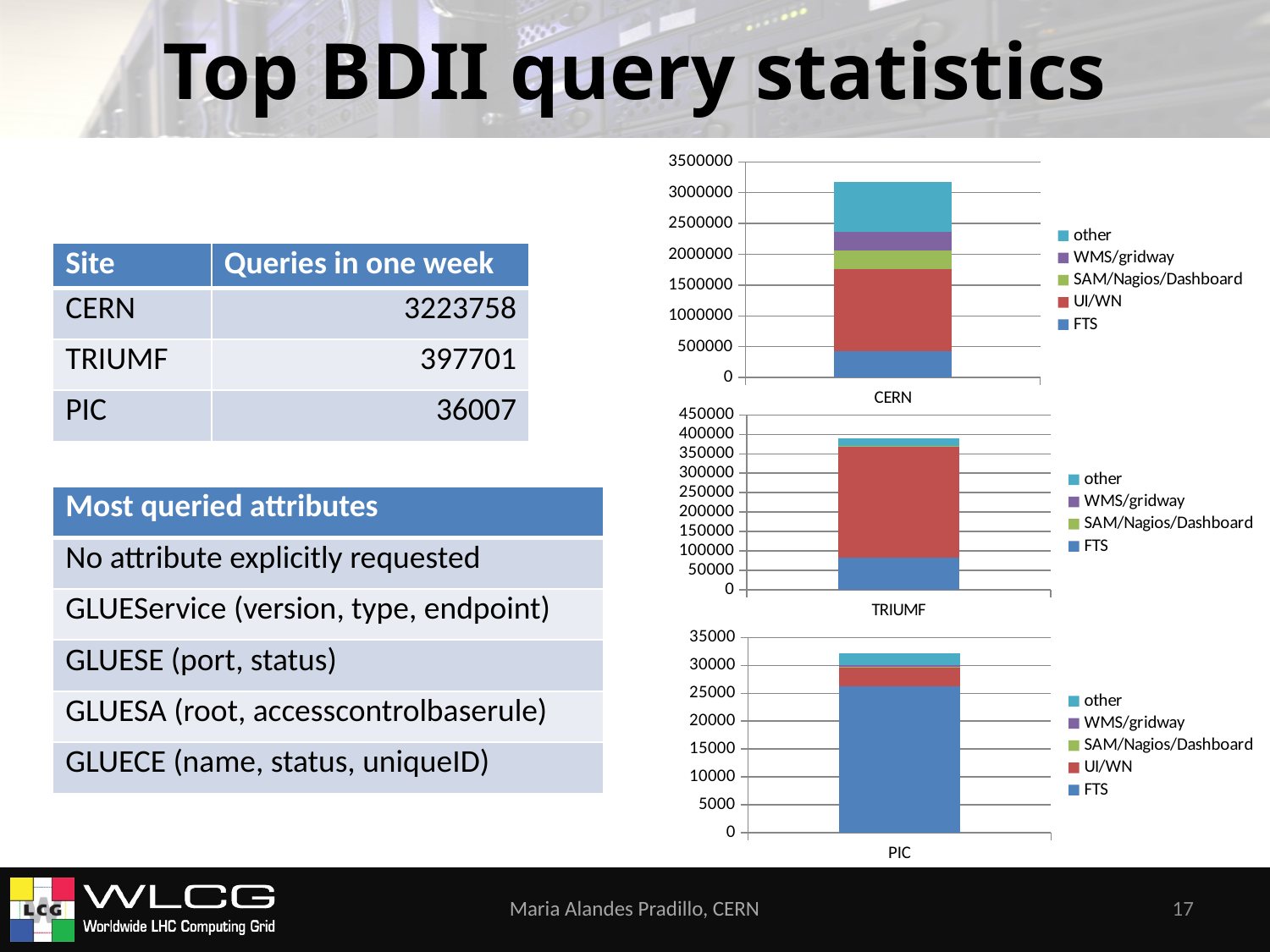
How many categories are plotted on the x axis of the PIC chart? 1 How many series does the legend of the CERN chart list? 5 How many series does the legend of the PIC chart list? 5 What kind of chart is the CERN chart? stacked bar chart In the CERN chart, which series has the largest segment in the stacked bar? UI/WN In the CERN chart, is the total height of the stacked bar greater or less than 3000000? greater How many series does the legend of the TRIUMF chart list? 4 In the TRIUMF chart, is the FTS segment greater or less than 100000? less In the PIC chart, which series has the largest segment in the stacked bar? FTS In the TRIUMF chart, is the total height of the stacked bar greater or less than 350000? greater